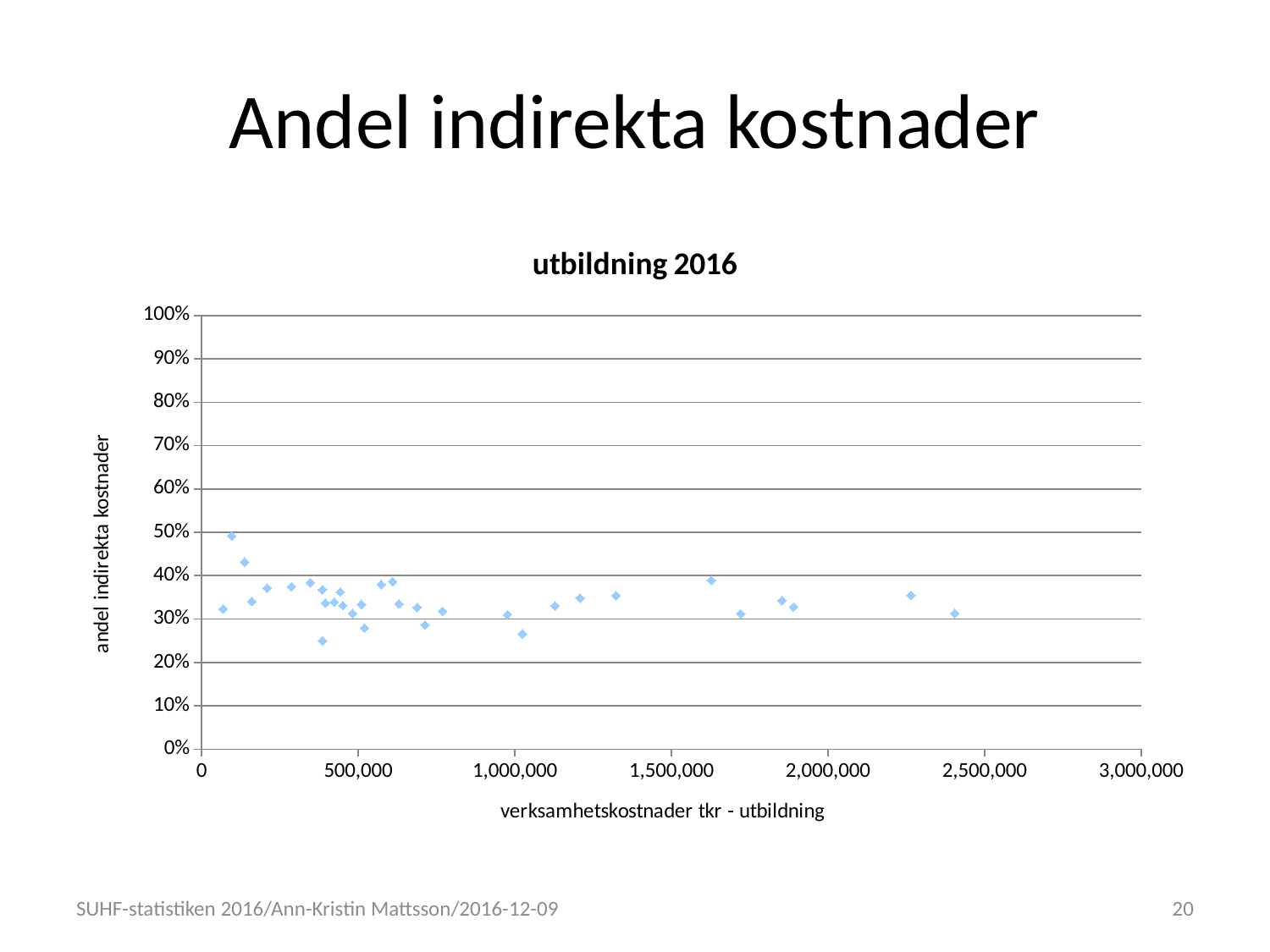
Are there any points above 50% on the vertical axis? no Is the lowest point on the chart greater or less than 20%? greater What kind of chart is shown on the slide? scatter chart Is the highest point on the chart greater or less than 60%? less What is the maximum value shown on the horizontal axis? 3,000,000 What is the label of the vertical axis? andel indirekta kostnader Do the values show a strong upward trend as the x value increases? no What is the title of the chart? utbildning 2016